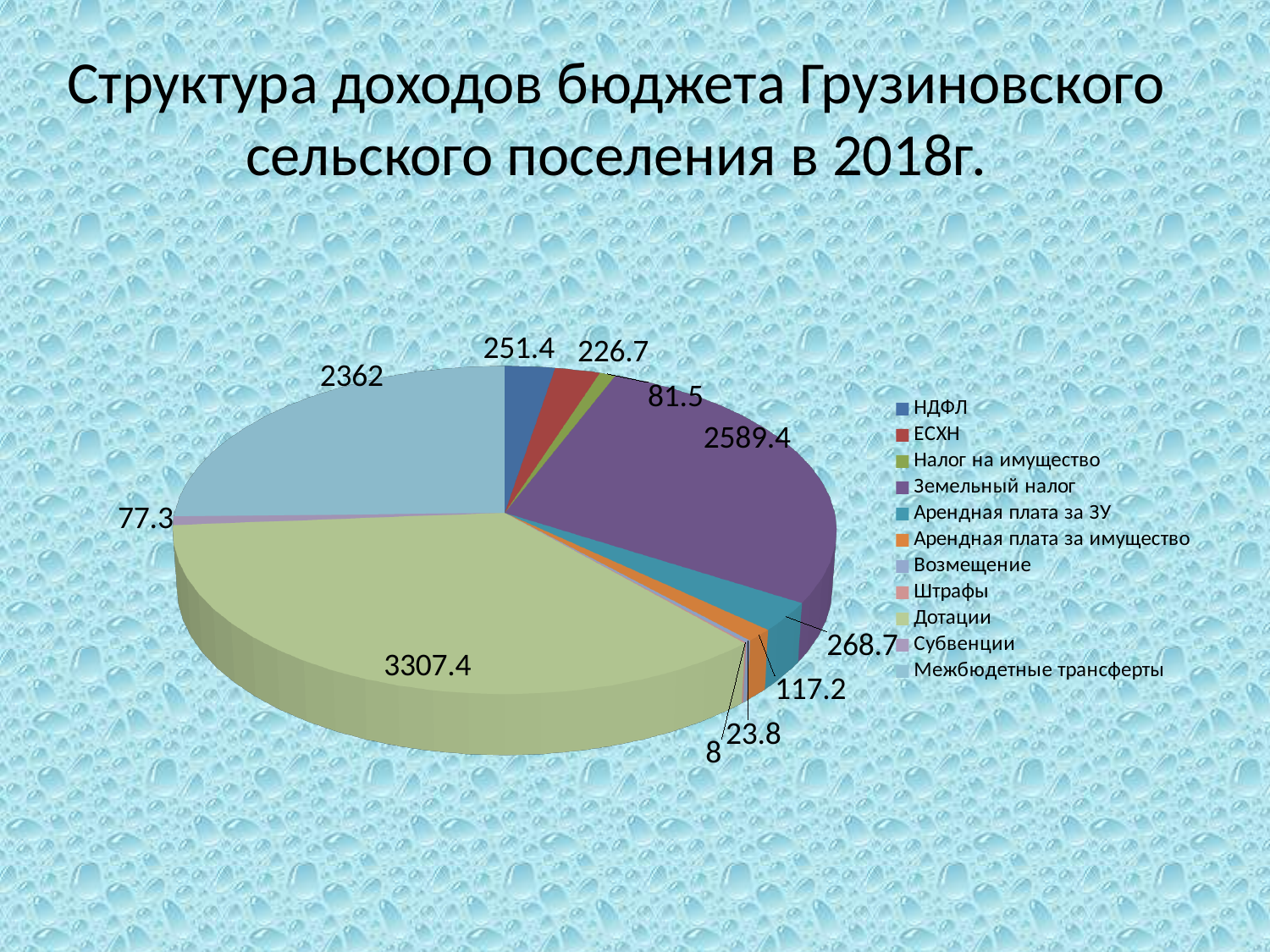
What is the difference between the values for НДФЛ and ЕСХН? 24.7 Which category has the largest slice of the pie? Дотации What is the value shown for Дотации? 3307.4 Which is larger, Земельный налог or Межбюджетные трансферты? Земельный налог What is the difference between the values for Дотации and Земельный налог? 718 How many categories does the legend of the pie chart list? 11 What is the value shown for Земельный налог? 2589.4 What kind of chart is shown on the slide? pie chart What is the value shown for Субвенции? 77.3 What is the title of the slide containing the pie chart? Структура доходов бюджета Грузиновского сельского поселения в 2018г. Which category has the smallest slice of the pie? Штрафы What is the value shown for НДФЛ? 251.4